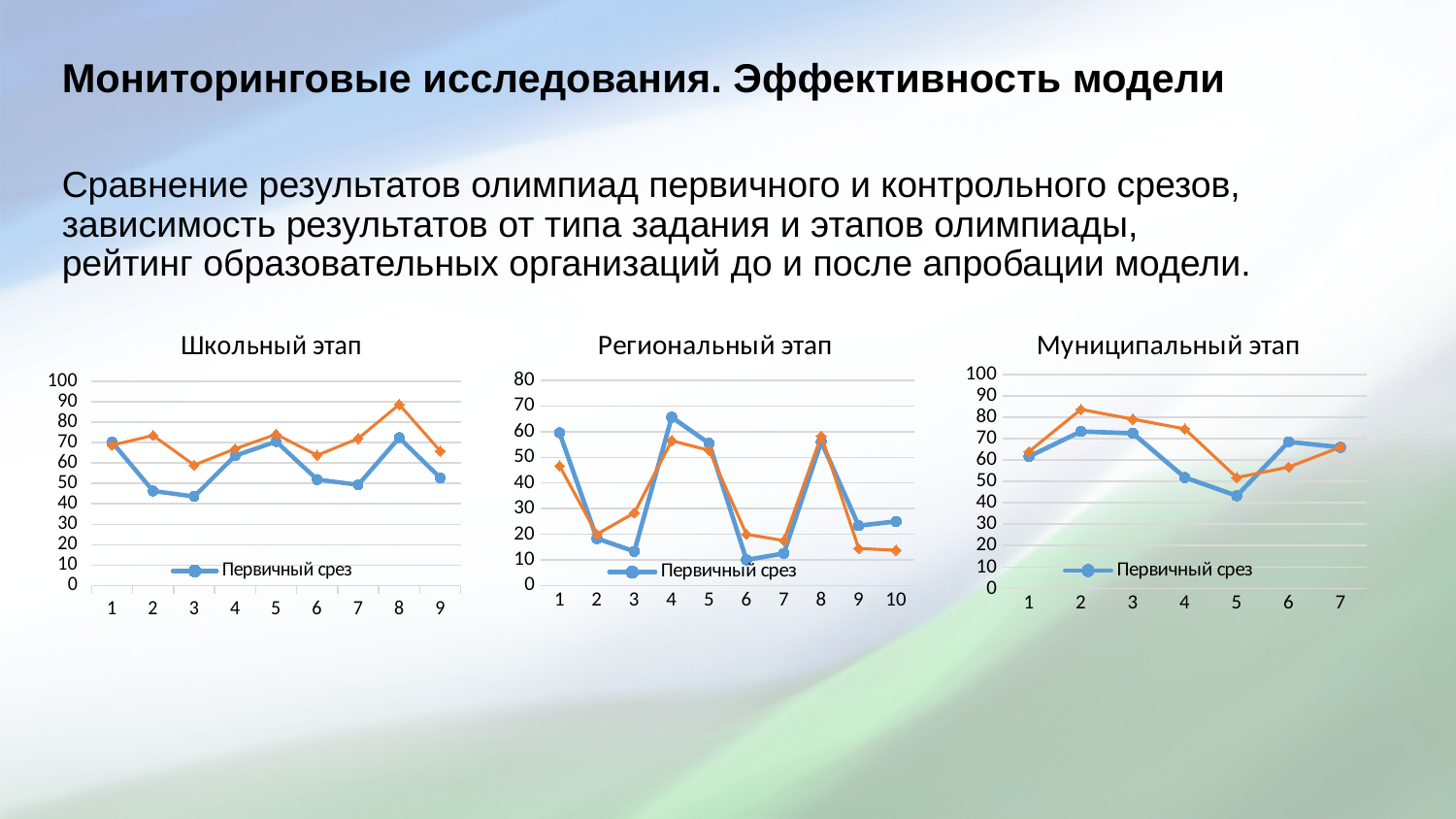
How many points are plotted along the x axis of the "Муниципальный этап" chart? 7 In the "Региональный этап" chart, is the blue line's value at point 6 greater or less than 20? less How many points are plotted along the x axis of the "Школьный этап" chart? 9 In the "Школьный этап" chart, is the orange line's value at point 8 greater or less than 80? greater In the "Региональный этап" chart, at which x-axis point does the blue line reach its highest value? 4 In the "Школьный этап" chart, at which x-axis point does the orange line reach its highest value? 8 In the "Муниципальный этап" chart, which line has the larger value at point 4, the blue or the orange? orange What is the title of the middle chart on the slide? Региональный этап What kind of chart is the "Школьный этап" chart? line chart In the "Региональный этап" chart, which line has the larger value at point 1, the blue or the orange? blue In the "Муниципальный этап" chart, at which x-axis point does the blue line reach its lowest value? 5 How many points are plotted along the x axis of the "Региональный этап" chart? 10